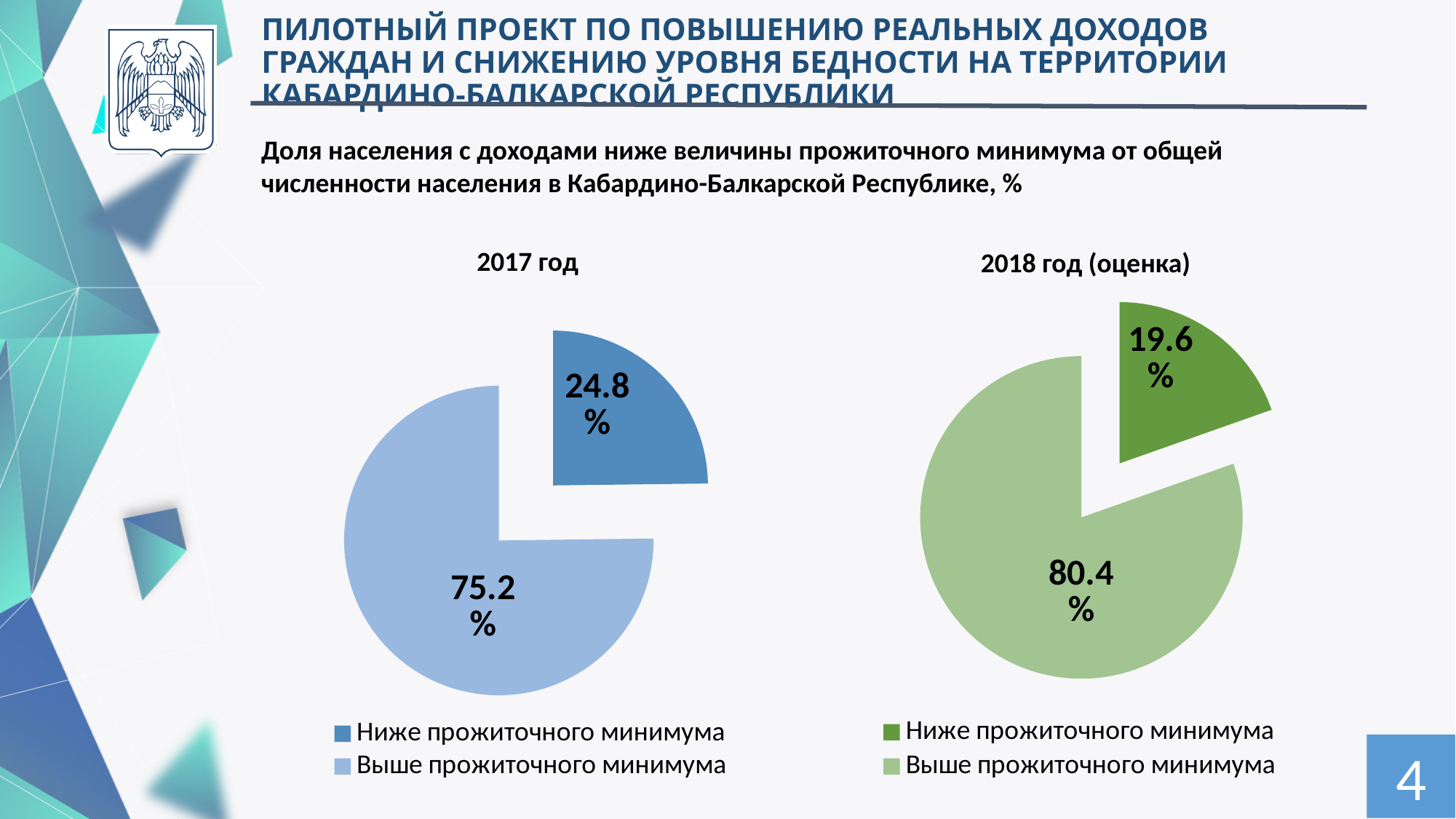
How many entries does the legend of the "2017 год" chart list? 2 Is the value for "Ниже прожиточного минимума" larger in the "2017 год" chart or in the "2018 год (оценка)" chart? 2017 год In the "2018 год (оценка)" chart, what is the value for "Ниже прожиточного минимума"? 19.6% In the "2017 год" chart, what is the value for "Ниже прожиточного минимума"? 24.8% In the "2017 год" chart, which category has the largest slice? Выше прожиточного минимума In the "2018 год (оценка)" chart, what is the difference between "Выше прожиточного минимума" and "Ниже прожиточного минимума"? 60.8% In the "2017 год" chart, what is the value for "Выше прожиточного минимума"? 75.2% In the "2018 год (оценка)" chart, which category has the smallest slice? Ниже прожиточного минимума In the "2017 год" chart, what is the difference between "Выше прожиточного минимума" and "Ниже прожиточного минимума"? 50.4% What kind of chart is the "2017 год" chart? Pie chart How many slices does the "2018 год (оценка)" chart have? 2 In the "2018 год (оценка)" chart, what is the value for "Выше прожиточного минимума"? 80.4%